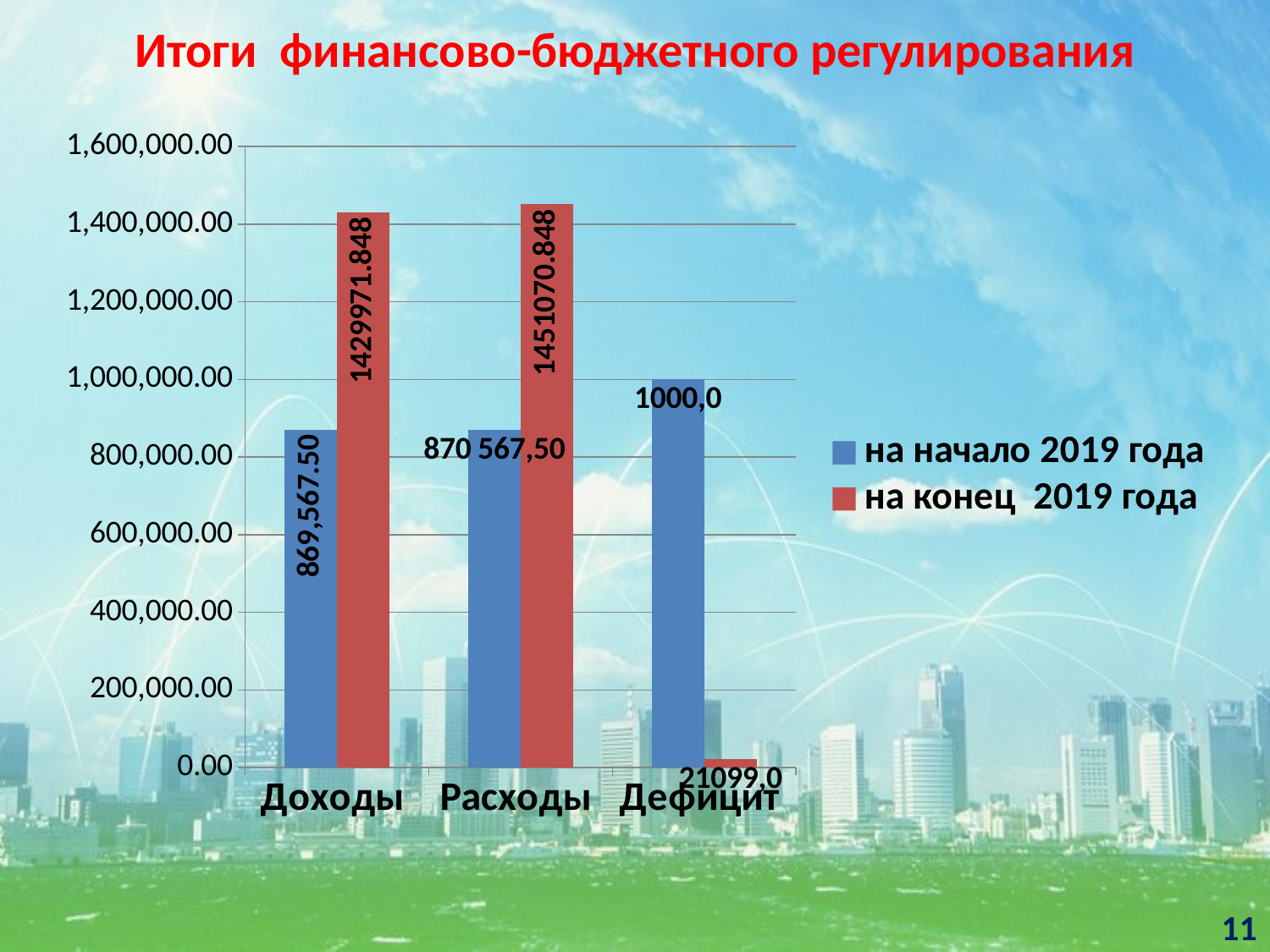
What is the value for Расходы in the series 'на начало 2019 года'? 870 567,50 What is the value for Доходы in the series 'на начало 2019 года'? 869,567.50 What kind of chart is shown on the slide? bar chart How many series does the legend list? 2 How many categories are shown on the x axis? 3 What is the title of the chart? Итоги финансово-бюджетного регулирования What is the value for Расходы in the series 'на конец 2019 года'? 1451070.848 Is the value for Доходы in the series 'на начало 2019 года' greater or less than 800,000.00? greater What is the data label for Дефицит in the series 'на конец 2019 года'? 21099,0 Which category has the highest value in the series 'на конец 2019 года'? Расходы Which category has the lowest value in the series 'на конец 2019 года'? Дефицит What is the value for Доходы in the series 'на конец 2019 года'? 1429971.848